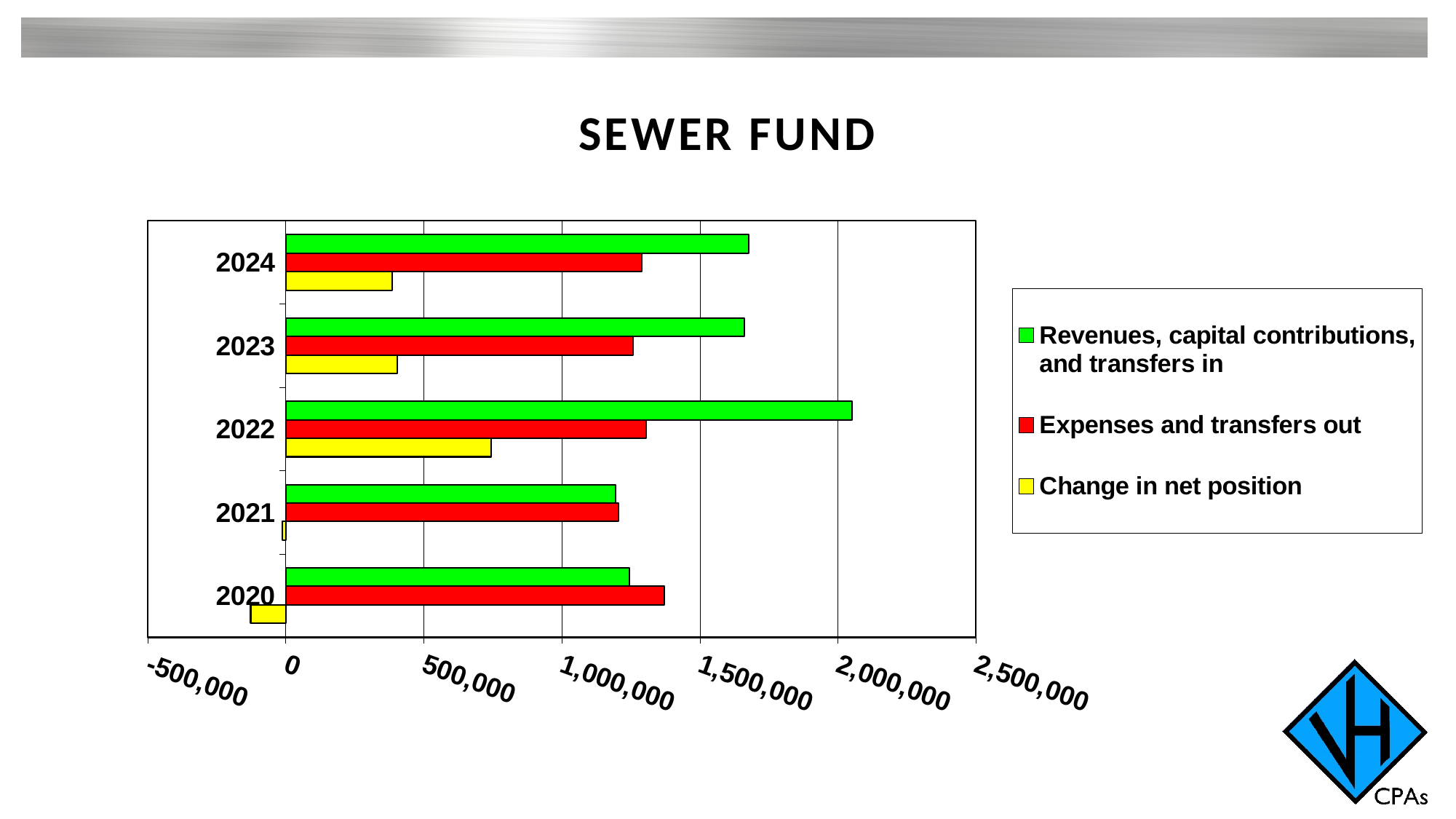
Is the value for Change in net position for 2020 greater or less than 0? less What kind of chart is shown on the slide? bar chart In which year is Change in net position the lowest? 2020 Is the value for Change in net position for 2022 greater or less than 500,000? greater How many series does the legend list? 3 Which colour represents Change in net position? yellow In 2020, which is larger: Revenues, capital contributions, and transfers in or Expenses and transfers out? Expenses and transfers out What is the title of the chart? SEWER FUND In which year is Revenues, capital contributions, and transfers in the highest? 2022 In which year is Change in net position the highest? 2022 How many years are shown on the chart? 5 Is the value for Revenues, capital contributions, and transfers in for 2024 greater or less than 1,500,000? greater